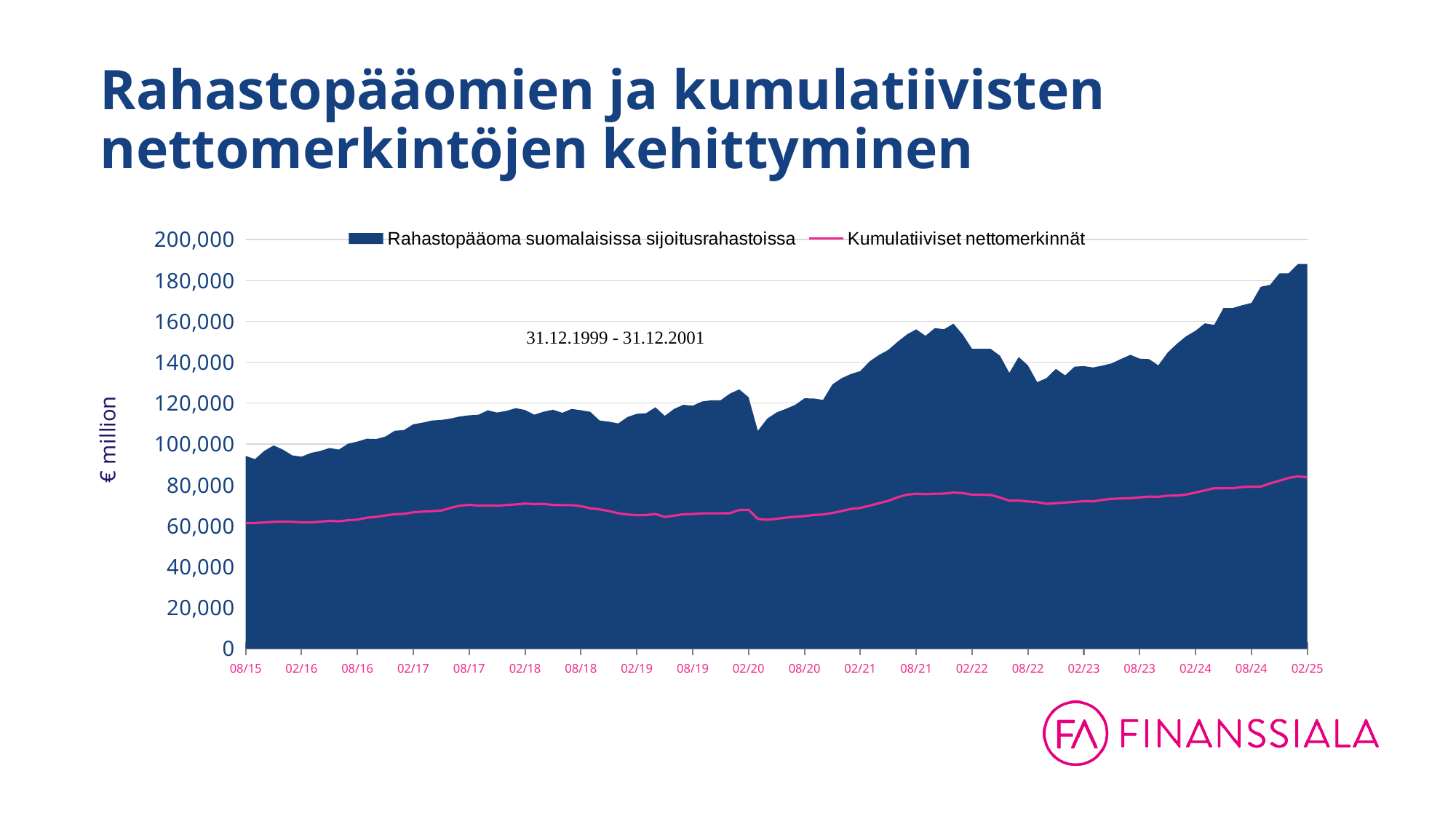
Is the value of Rahastopääoma suomalaisissa sijoitusrahastoissa at 08/15 greater or less than 100,000? less What are the two series named in the legend? Rahastopääoma suomalaisissa sijoitusrahastoissa; Kumulatiiviset nettomerkinnät Does the Rahastopääoma suomalaisissa sijoitusrahastoissa series overall rise or fall from 08/15 to 02/25? rise What is the label on the vertical axis of the chart? € million Which series has the larger value at 02/25, Rahastopääoma suomalaisissa sijoitusrahastoissa or Kumulatiiviset nettomerkinnät? Rahastopääoma suomalaisissa sijoitusrahastoissa Is the value of Kumulatiiviset nettomerkinnät at 02/25 greater or less than 80,000? greater How many series does the chart legend list? 2 Is the value of Rahastopääoma suomalaisissa sijoitusrahastoissa at 02/25 greater or less than 180,000? greater How many date labels are shown on the x axis of the chart? 20 What kind of chart is shown on the slide? Area chart with a line series